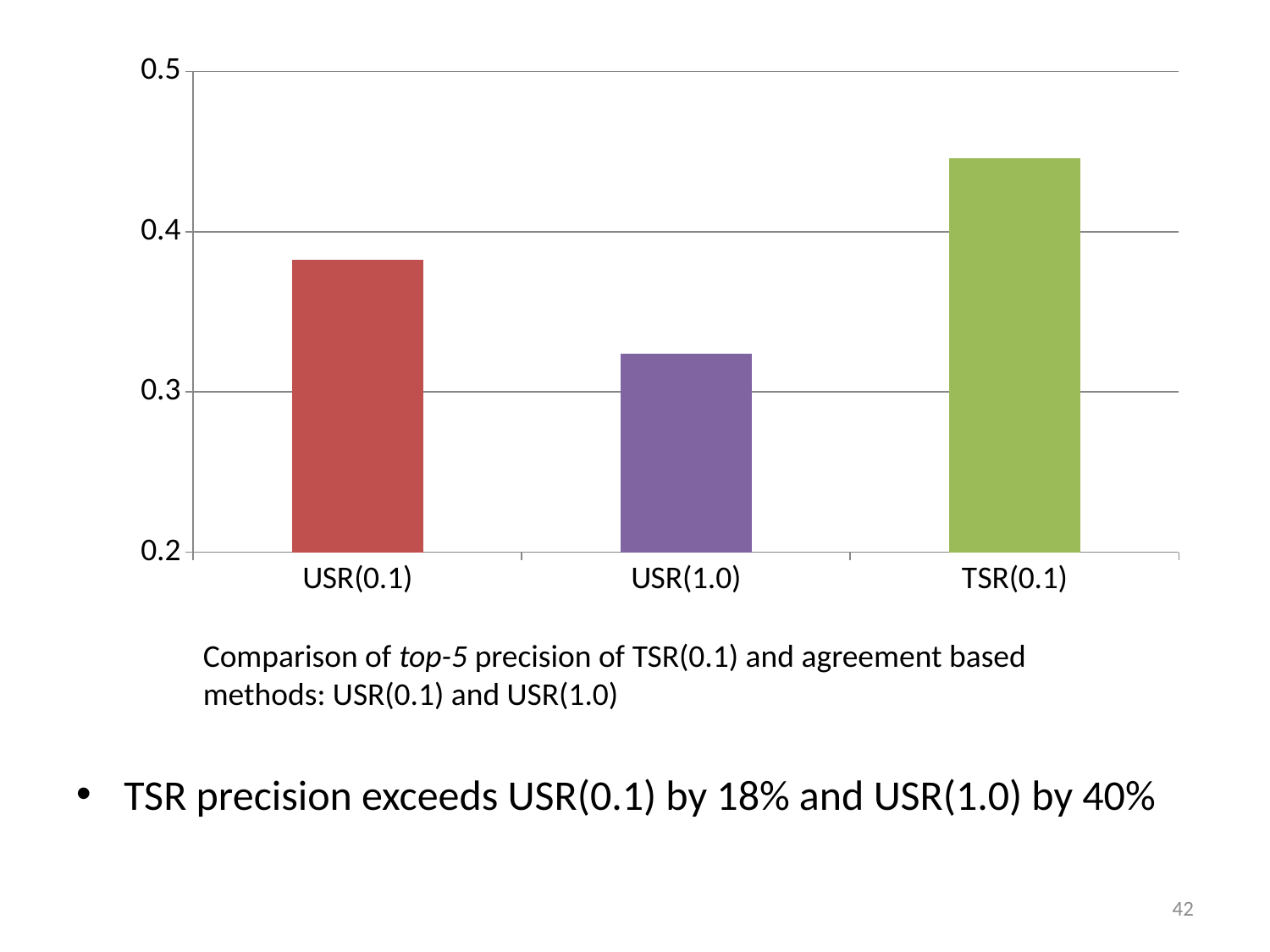
Which is larger, the value for USR(0.1) or the value for USR(1.0)? USR(0.1) How many categories are shown on the x axis? 3 What is the lowest value shown on the y axis? 0.2 What colour is the bar for TSR(0.1)? green Which category has the highest bar? TSR(0.1) Is the value for USR(0.1) greater or less than 0.3? greater Which category has the lowest bar? USR(1.0) Is the value for USR(1.0) greater or less than 0.3? greater Is the value for TSR(0.1) greater or less than 0.4? greater What kind of chart is shown on the slide? bar chart Which is larger, the value for TSR(0.1) or the value for USR(0.1)? TSR(0.1)